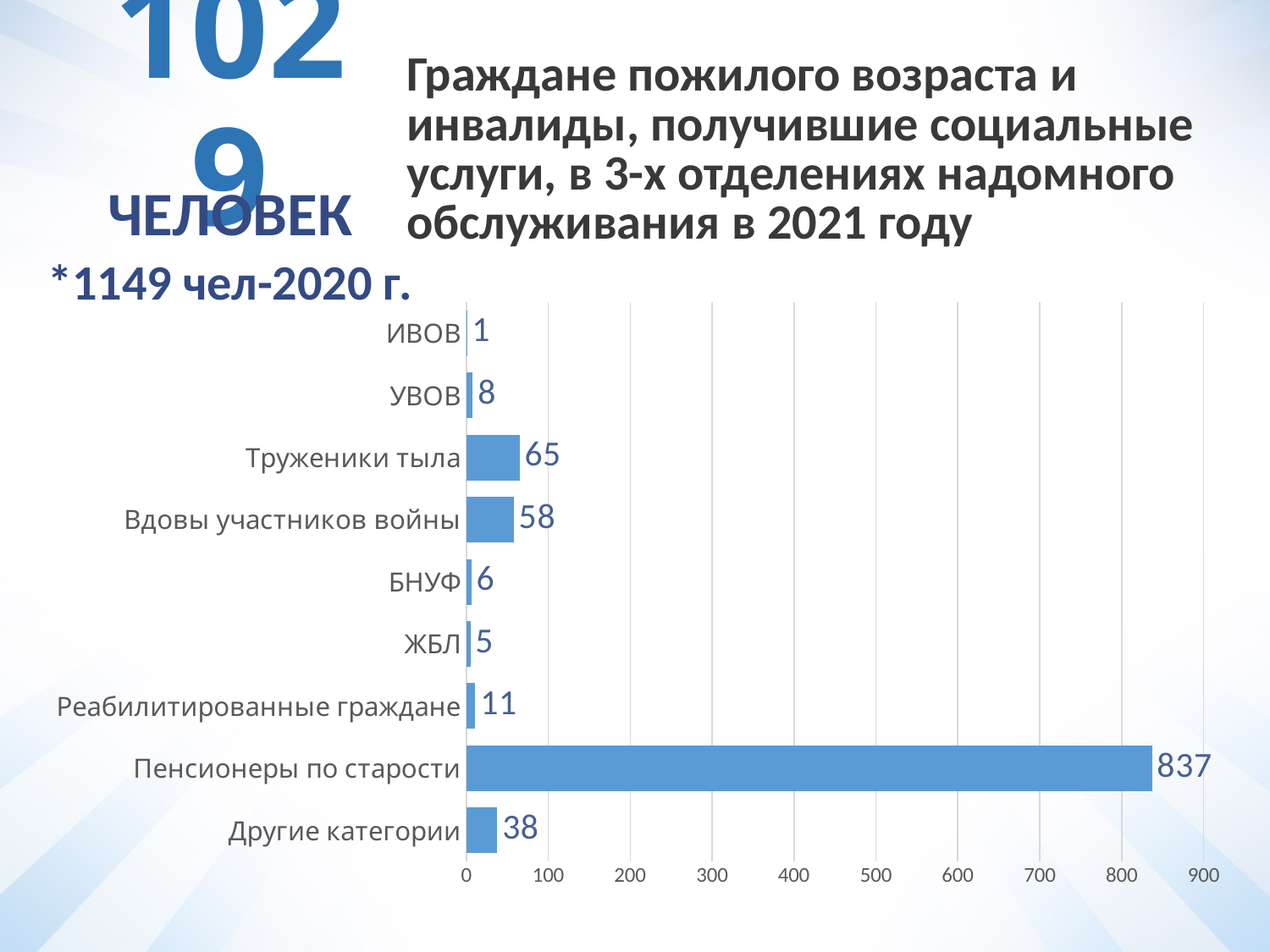
What kind of chart is shown on the slide? bar chart What is the difference between the values for УВОВ and ИВОВ? 7 Which category has the highest value? Пенсионеры по старости What is the value for Реабилитированные граждане? 11 Which is larger, the value for Другие категории or the value for Реабилитированные граждане? Другие категории What is the value for Пенсионеры по старости? 837 What is the difference between the values for Труженики тыла and Вдовы участников войны? 7 How many categories are shown in the chart? 9 Which category has the lowest value? ИВОВ What is the value for Труженики тыла? 65 Is the value for Пенсионеры по старости greater or less than 800? greater What is the value for Вдовы участников войны? 58